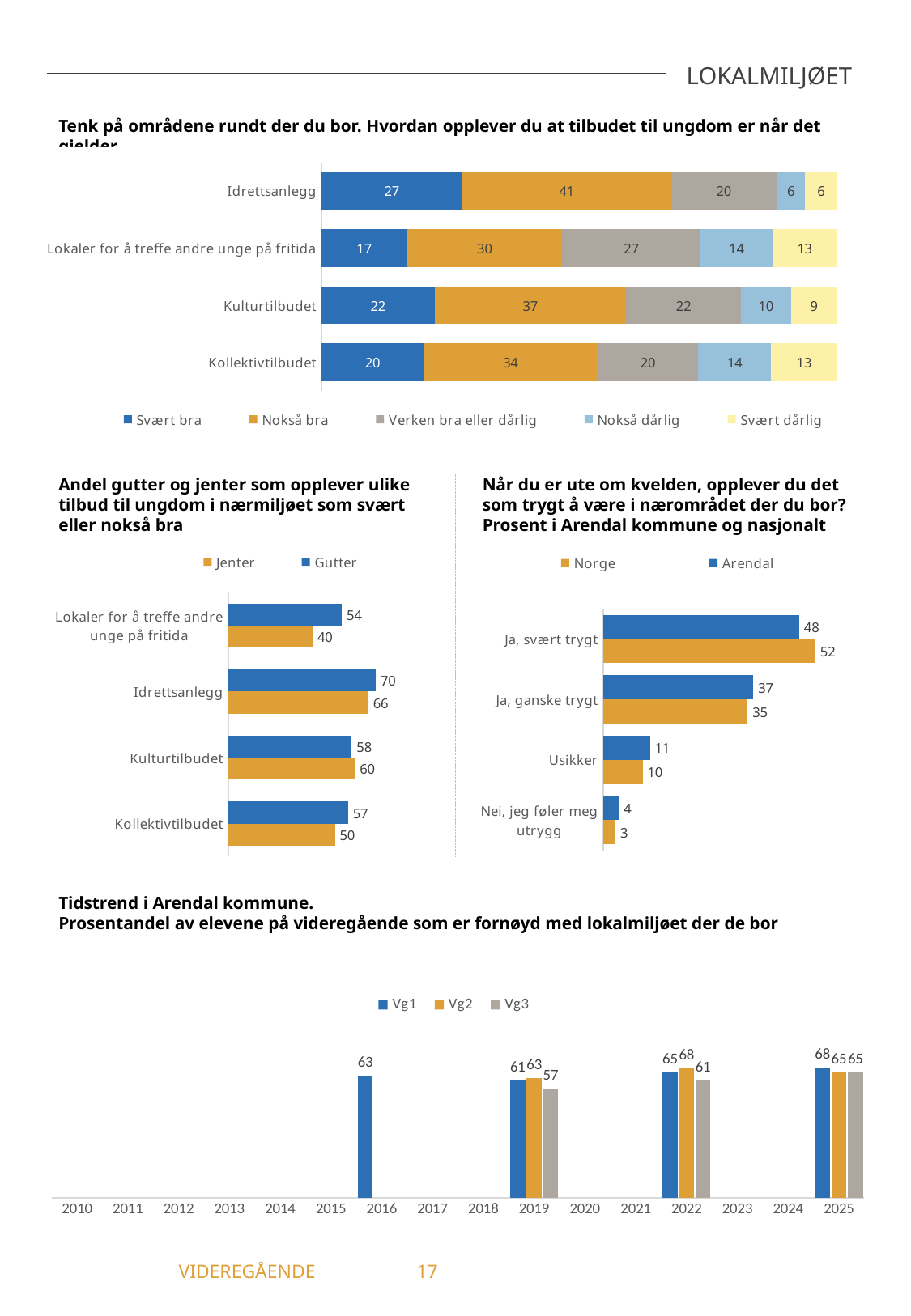
In the top stacked bar chart, how many series does the legend list? 5 In the chart 'Andel gutter og jenter som opplever ulike tilbud til ungdom i nærmiljøet som svært eller nokså bra', what is the difference between Gutter and Jenter for Lokaler for å treffe andre unge på fritida? 14 In the chart 'Andel gutter og jenter som opplever ulike tilbud til ungdom i nærmiljøet som svært eller nokså bra', which is larger for Kulturtilbudet, Jenter or Gutter? Jenter In the chart 'Tidstrend i Arendal kommune', how many series does the legend list? 3 In the chart 'Andel gutter og jenter som opplever ulike tilbud til ungdom i nærmiljøet som svært eller nokså bra', what is the value for Gutter for Idrettsanlegg? 70 In the top stacked bar chart, which category has the highest 'Svært bra' value? Idrettsanlegg In the chart 'Når du er ute om kvelden, opplever du det som trygt å være i nærområdet der du bor?', which category has the lowest Arendal value? Nei, jeg føler meg utrygg In the top stacked bar chart, what is the difference between the 'Svært dårlig' values for Kollektivtilbudet and Idrettsanlegg? 7 What kind of chart is the 'Tidstrend i Arendal kommune' chart? Bar chart In the chart 'Tidstrend i Arendal kommune', what is the Vg2 value for 2022? 68 In the chart 'Når du er ute om kvelden, opplever du det som trygt å være i nærområdet der du bor?', what is the Norge value for 'Ja, svært trygt'? 52 In the top stacked bar chart, what percentage answered 'Nokså bra' for Idrettsanlegg? 41